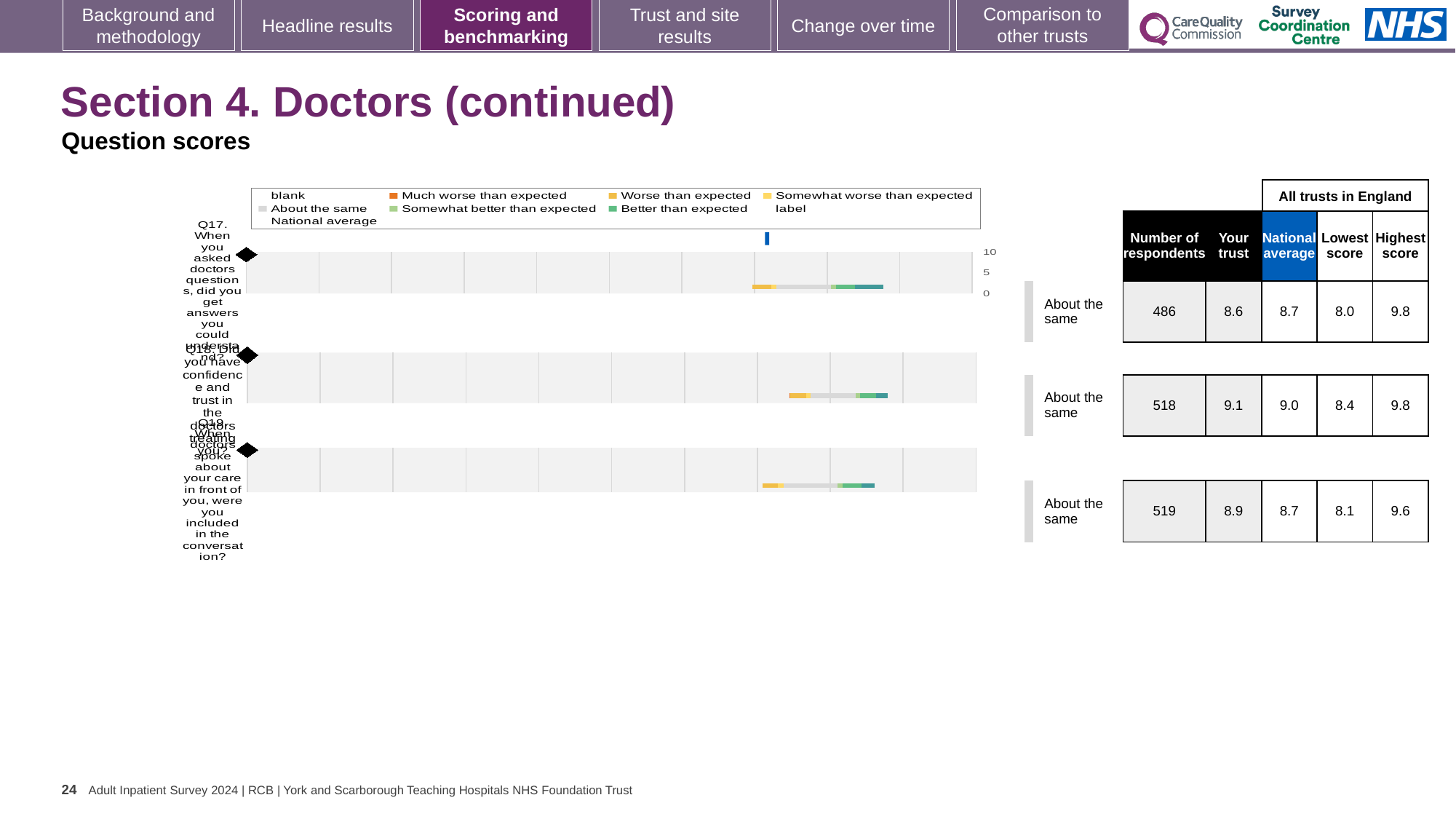
How many questions (categories) are plotted in the question scores charts? 3 What is the 'Your trust' score for Q17 (When you asked doctors questions, did you get answers you could understand?)? 8.6 What is the national average score for Q19 (When doctors spoke about your care in front of you, were you included in the conversation?)? 8.7 What type of chart is used to show the question scores on this slide? bar chart For Q17, which is larger: the 'Your trust' score or the national average? National average Which question has the highest 'Your trust' score? Q18 What benchmark category is shown for Q18? About the same What is the number of respondents for Q17? 486 What is the 'Your trust' score for Q18 (Did you have confidence and trust in the doctors treating you?)? 9.1 What is the difference between the 'Your trust' score and the national average for Q19? 0.2 Which question has the lowest 'Your trust' score? Q17 What is the highest score among all trusts in England for Q19? 9.6